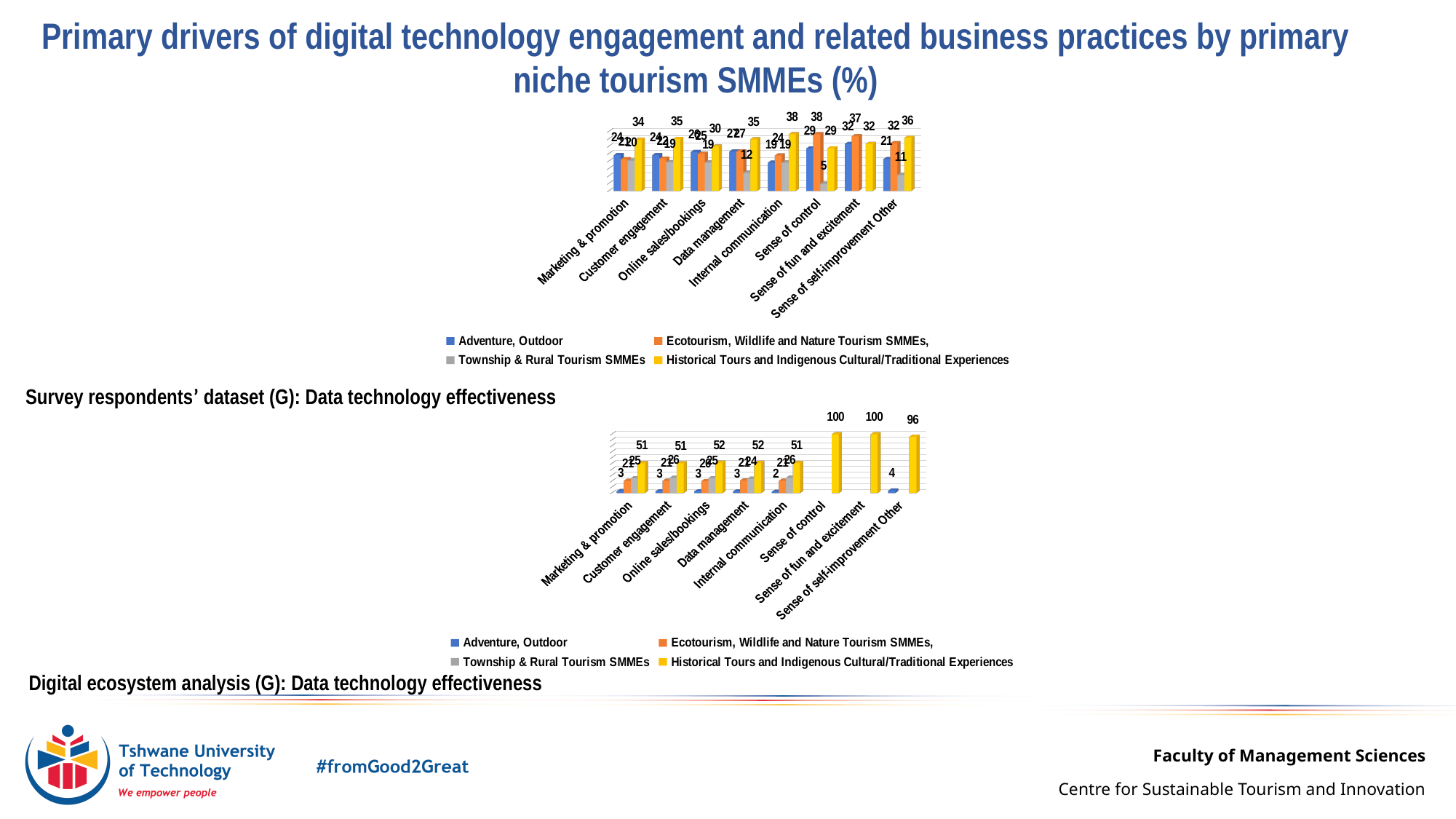
How many series does the legend of the bottom chart (Digital ecosystem analysis) list? 4 In the bottom chart (Digital ecosystem analysis), what is the value for Historical Tours and Indigenous Cultural/Traditional Experiences at Sense of self-improvement Other? 96 In the bottom chart (Digital ecosystem analysis), which is larger: the Historical Tours value at Online sales/bookings or the Adventure, Outdoor value at Online sales/bookings? Historical Tours and Indigenous Cultural/Traditional Experiences In the top chart (Survey respondents' dataset), how many categories are shown on the x axis? 8 In the bottom chart (Digital ecosystem analysis), what is the value for Adventure, Outdoor at Internal communication? 2 In the top chart (Survey respondents' dataset), what is the value for Historical Tours and Indigenous Cultural/Traditional Experiences at Internal communication? 38 In the top chart (Survey respondents' dataset), what is the value for Township & Rural Tourism SMMEs at Data management? 12 What type of chart is the top chart (Survey respondents' dataset)? Bar chart In the bottom chart (Digital ecosystem analysis), what is the difference between the Historical Tours value at Sense of control (100) and at Sense of self-improvement Other (96)? 4 In the top chart (Survey respondents' dataset), what is the value for Township & Rural Tourism SMMEs at Sense of control? 5 In the top chart (Survey respondents' dataset), what is the value for Historical Tours and Indigenous Cultural/Traditional Experiences at Marketing & promotion? 34 In the bottom chart (Digital ecosystem analysis), what is the value for Historical Tours and Indigenous Cultural/Traditional Experiences at Sense of control? 100